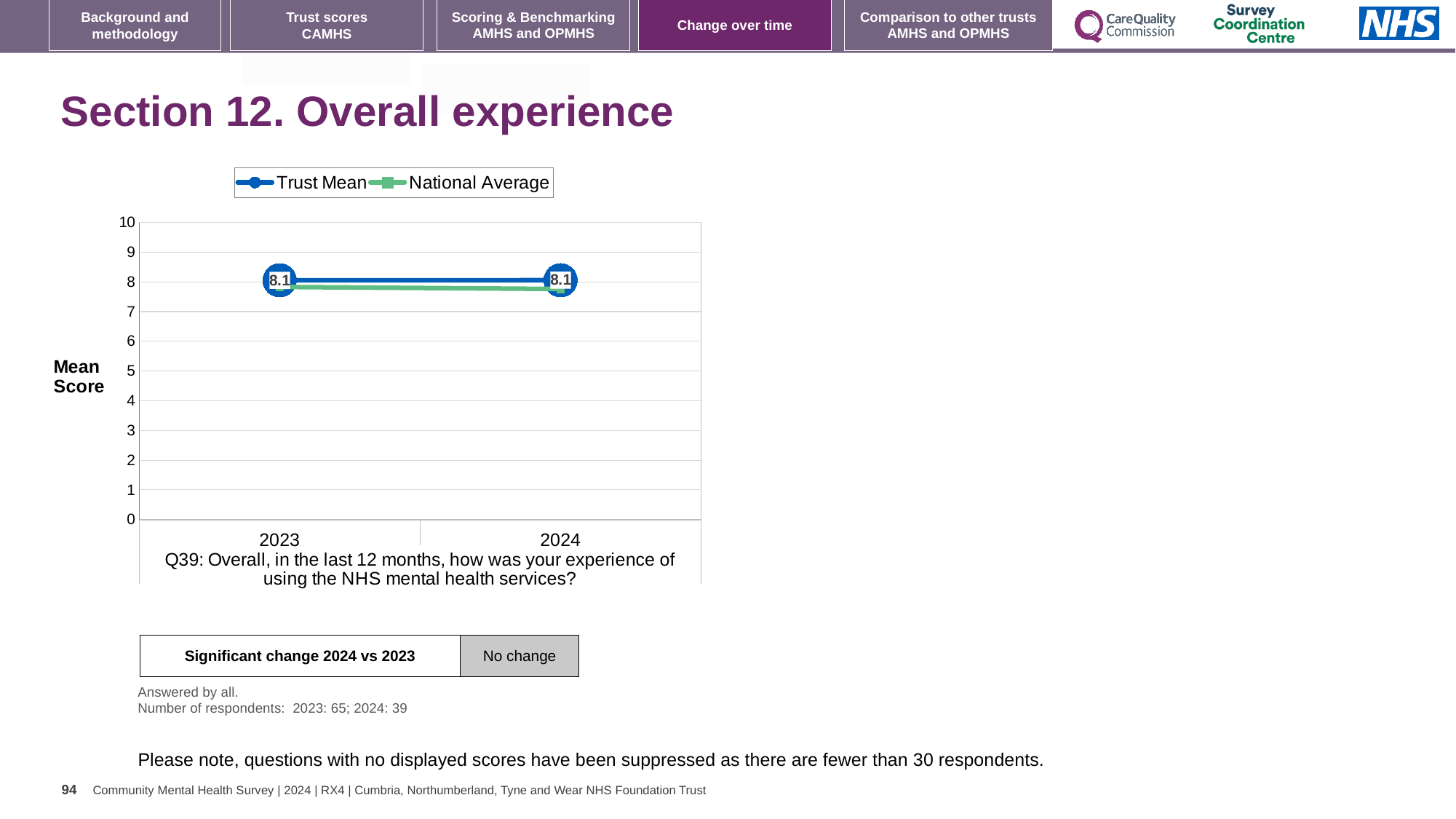
What kind of chart is shown on the slide? Line chart What is the Trust Mean value for 2023? 8.1 What is the Trust Mean value for 2024? 8.1 How many years are plotted along the x axis? 2 How many series does the chart legend list? 2 What is the difference between the Trust Mean in 2024 and in 2023? 0 What is the label on the y axis of the chart? Mean Score In 2024, which is higher: the Trust Mean or the National Average? Trust Mean What are the two series named in the chart legend? Trust Mean and National Average Does the Trust Mean rise, fall or stay the same from 2023 to 2024? Stays the same Is the National Average value for 2024 greater or less than 5? greater